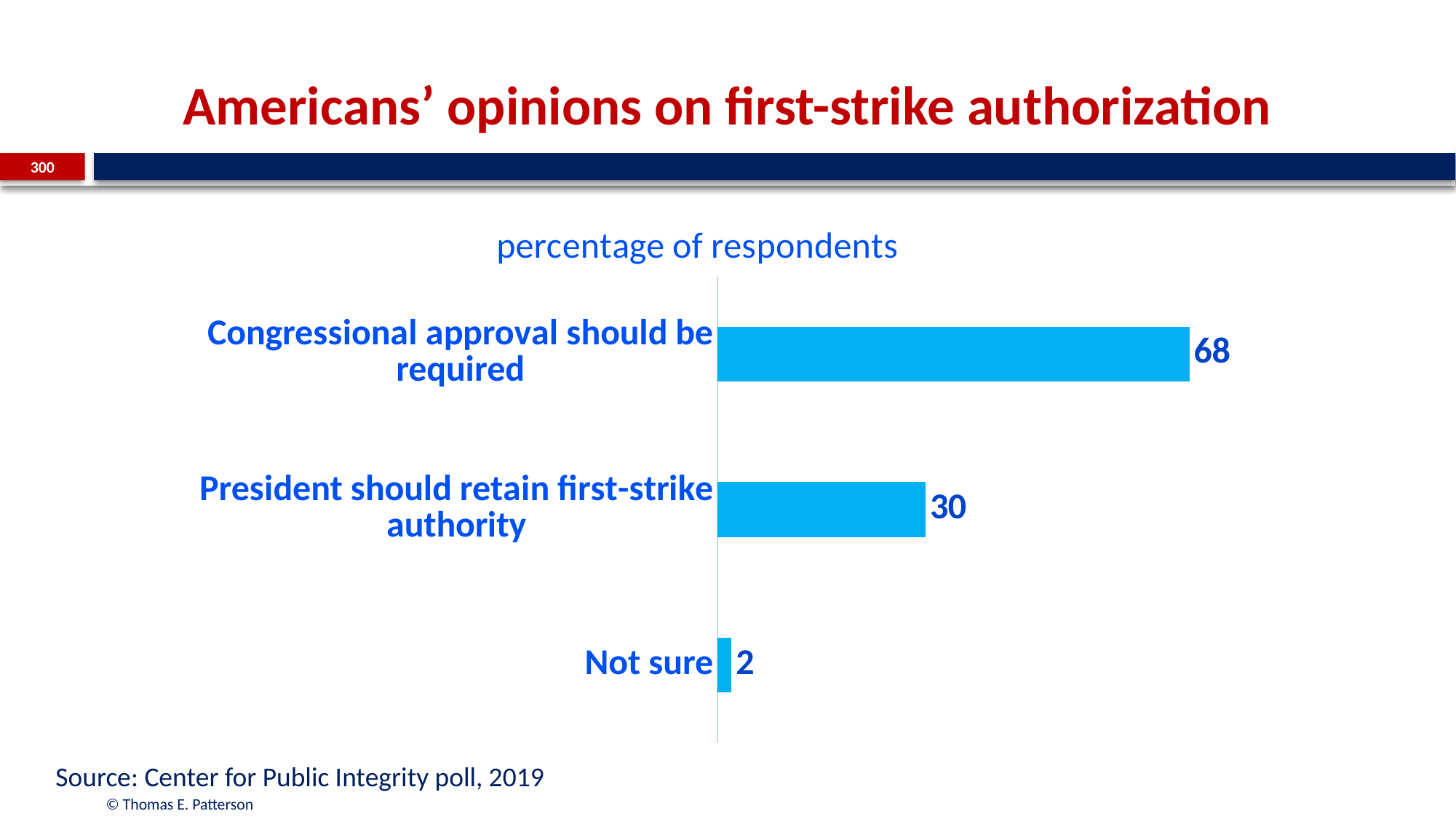
What is the source of the data shown in the chart? Center for Public Integrity poll, 2019 What percentage of respondents said congressional approval should be required? 68 What percentage of respondents were not sure? 2 Which is larger: the percentage for 'President should retain first-strike authority' or for 'Not sure'? President should retain first-strike authority What is the title of the chart? percentage of respondents Which response category has the lowest percentage of respondents? Not sure What kind of chart is shown on the slide? Bar chart Which response category has the highest percentage of respondents? Congressional approval should be required How many response categories are shown in the chart? 3 What is the difference in percentage points between 'Congressional approval should be required' and 'President should retain first-strike authority'? 38 What percentage of respondents said the President should retain first-strike authority? 30 What is the difference in percentage points between 'President should retain first-strike authority' and 'Not sure'? 28